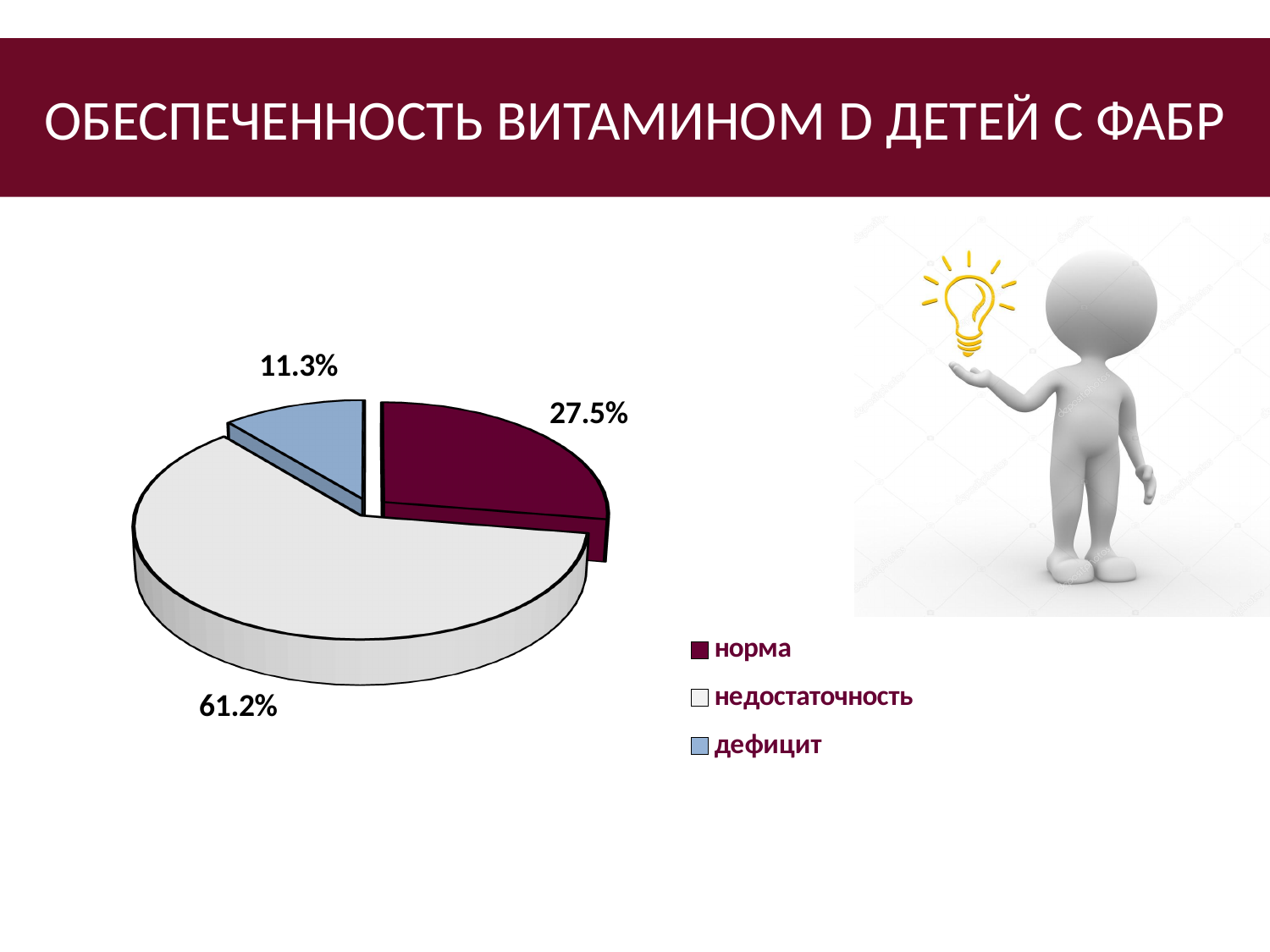
Which slice is larger, 'норма' or 'дефицит'? норма What share of the pie does the 'недостаточность' slice represent? 61.2% What colour is the 'дефицит' slice in the pie chart? light blue How many entries does the legend list? 3 Which category has the largest slice of the pie? недостаточность How many slices does the pie chart have? 3 Which category has the smallest slice of the pie? дефицит What share of the pie does the 'норма' slice represent? 27.5% What kind of chart is shown on the slide? pie chart What share of the pie does the 'дефицит' slice represent? 11.3% What is the difference in percentage points between the 'недостаточность' and 'норма' slices? 33.7 What is the difference in percentage points between the 'норма' and 'дефицит' slices? 16.2